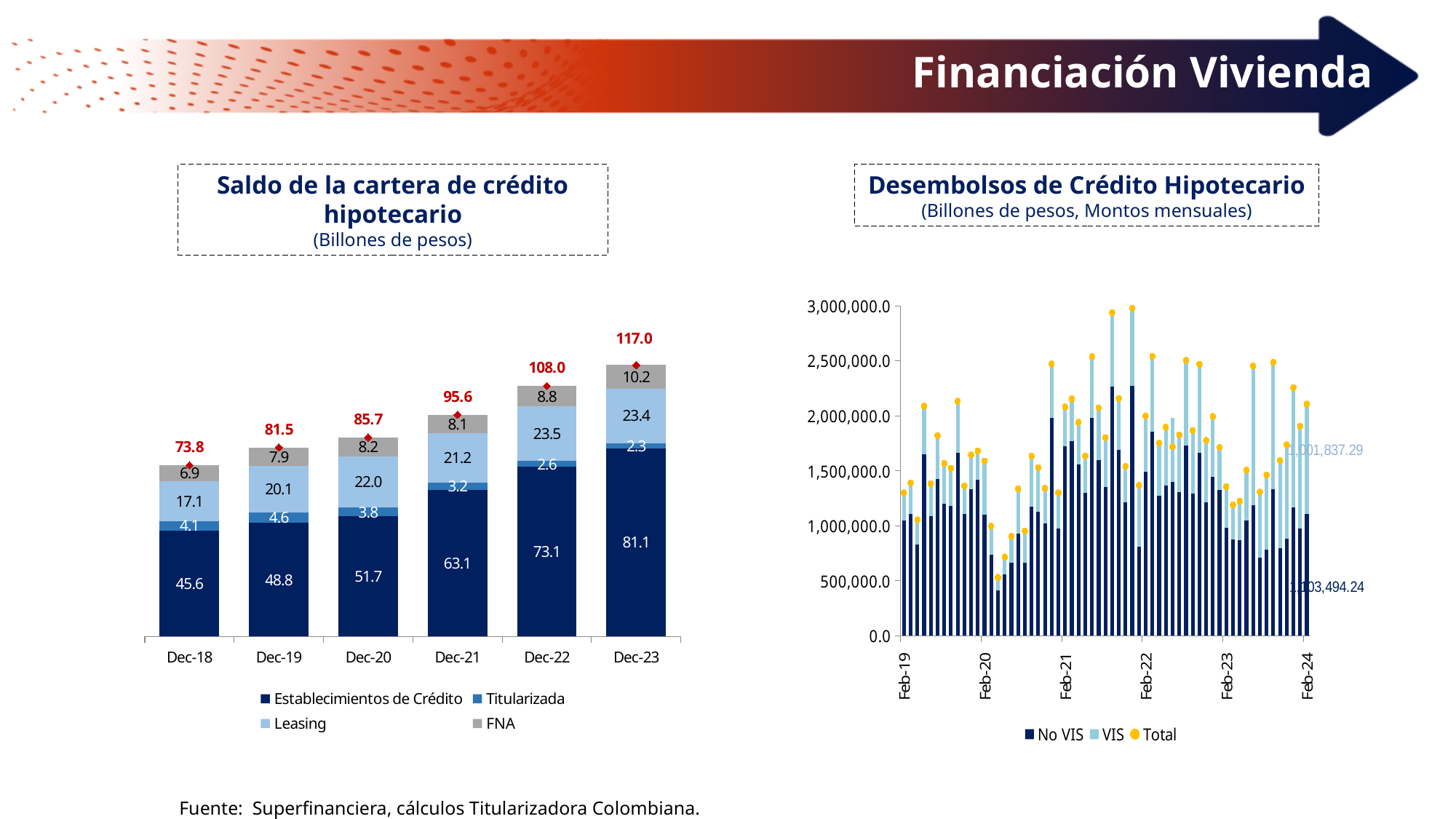
How many series does the legend of the chart 'Saldo de la cartera de crédito hipotecario' list? 4 In the chart 'Saldo de la cartera de crédito hipotecario', what is the value of Establecimientos de Crédito for Dec-21? 63.1 In the chart 'Saldo de la cartera de crédito hipotecario', what is the Leasing value for Dec-22? 23.5 In the chart 'Saldo de la cartera de crédito hipotecario', which is larger: Establecimientos de Crédito in Dec-20 or in Dec-19? Dec-20 In the chart 'Saldo de la cartera de crédito hipotecario', what is the difference between the totals for Dec-23 and Dec-22? 9.0 In the chart 'Saldo de la cartera de crédito hipotecario', do the totals rise or fall from Dec-18 to Dec-23? rise How many years (categories) are shown in the chart 'Saldo de la cartera de crédito hipotecario'? 6 In the chart 'Saldo de la cartera de crédito hipotecario', what is the total value shown above the Dec-23 bar? 117.0 In the chart 'Saldo de la cartera de crédito hipotecario', which year has the highest total? Dec-23 In the chart 'Saldo de la cartera de crédito hipotecario', which year has the lowest Titularizada value? Dec-23 How many series does the legend of the chart 'Desembolsos de Crédito Hipotecario' list? 3 In the chart 'Saldo de la cartera de crédito hipotecario', what is the FNA value for Dec-19? 7.9